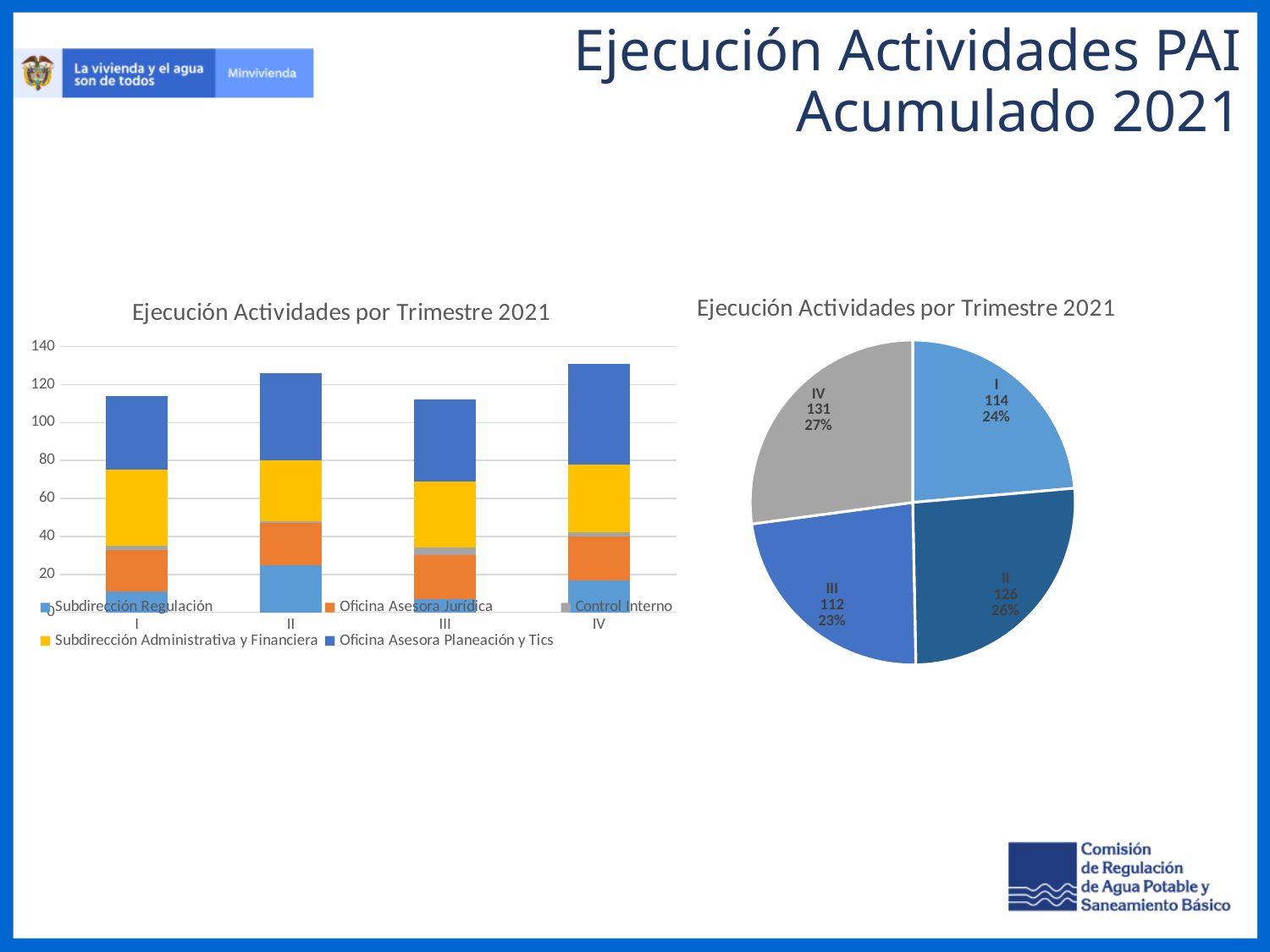
In the pie chart on the right, which quarter has the largest slice? IV In the pie chart on the right, what percentage share does slice II have? 26% In the bar chart on the left, which stacked bar is taller, I or II? II How many series does the legend of the bar chart on the left list? 5 How many categories are shown on the x axis of the bar chart on the left? 4 In the pie chart on the right, what value is shown for slice IV? 131 In the pie chart on the right, what is the difference between the values for IV and III? 19 In the bar chart on the left, is the total height of the bar for IV greater or less than 120? greater In the bar chart on the left, what colour represents Control Interno in the legend? Grey How many slices does the pie chart on the right have? 4 In the pie chart on the right, which quarter has the smallest slice? III What kind of chart is the chart on the left of the slide? Stacked bar chart